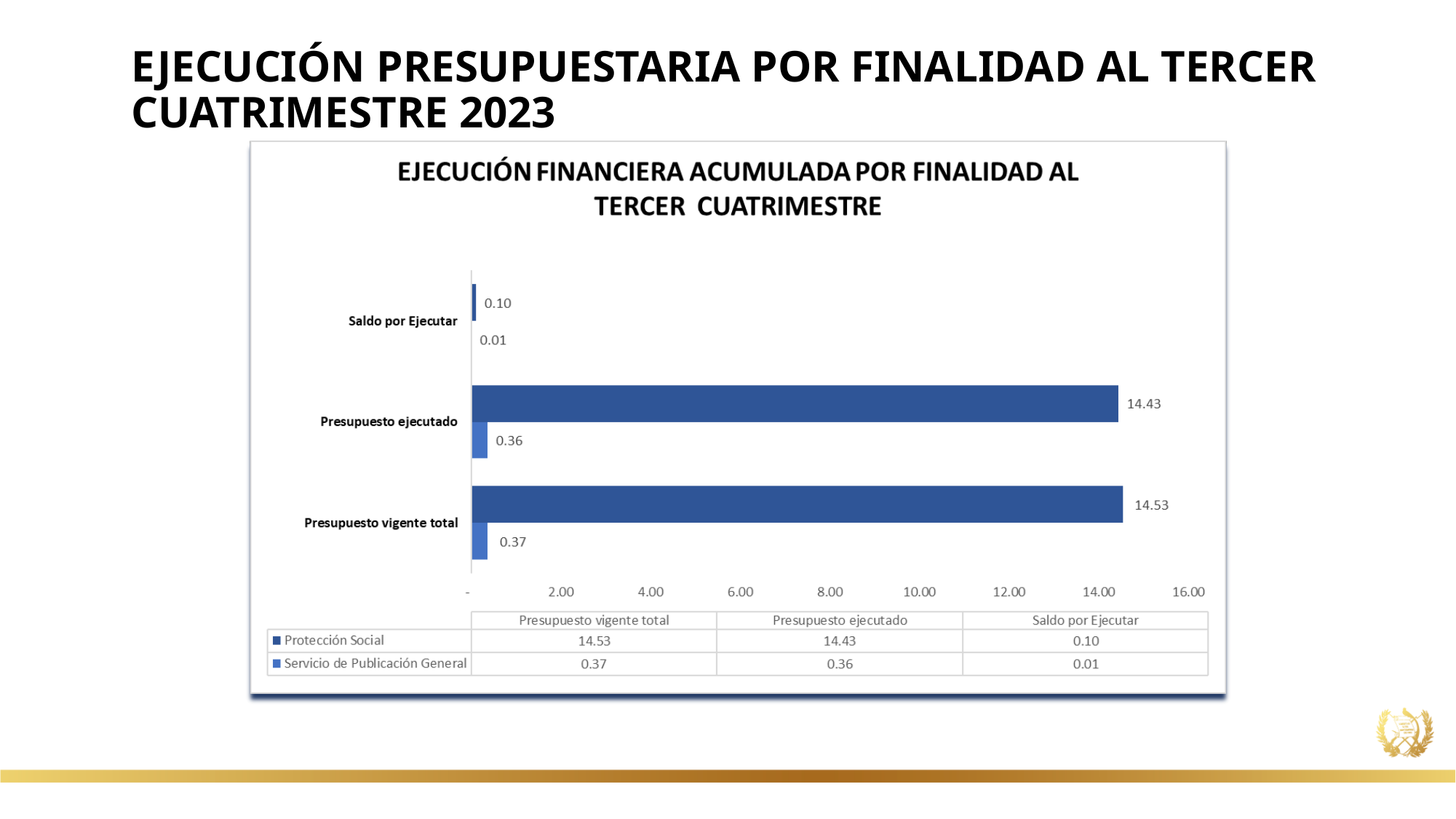
What is the difference between Protección Social's Presupuesto vigente total and Presupuesto ejecutado? 0.10 What kind of chart is shown on the slide? Bar chart What is the value of Servicio de Publicación General for Presupuesto ejecutado? 0.36 How many series does the legend list? 2 Is the value of Protección Social for Presupuesto ejecutado greater or less than 14.00? greater What is the value of Protección Social for Saldo por Ejecutar? 0.10 Which category has the highest value for Protección Social? Presupuesto vigente total How many categories are shown on the chart? 3 What is the value of Servicio de Publicación General for Saldo por Ejecutar? 0.01 What is the value of Protección Social for Presupuesto vigente total? 14.53 Which series has the larger value for Presupuesto ejecutado, Protección Social or Servicio de Publicación General? Protección Social Which category has the lowest value for Servicio de Publicación General? Saldo por Ejecutar